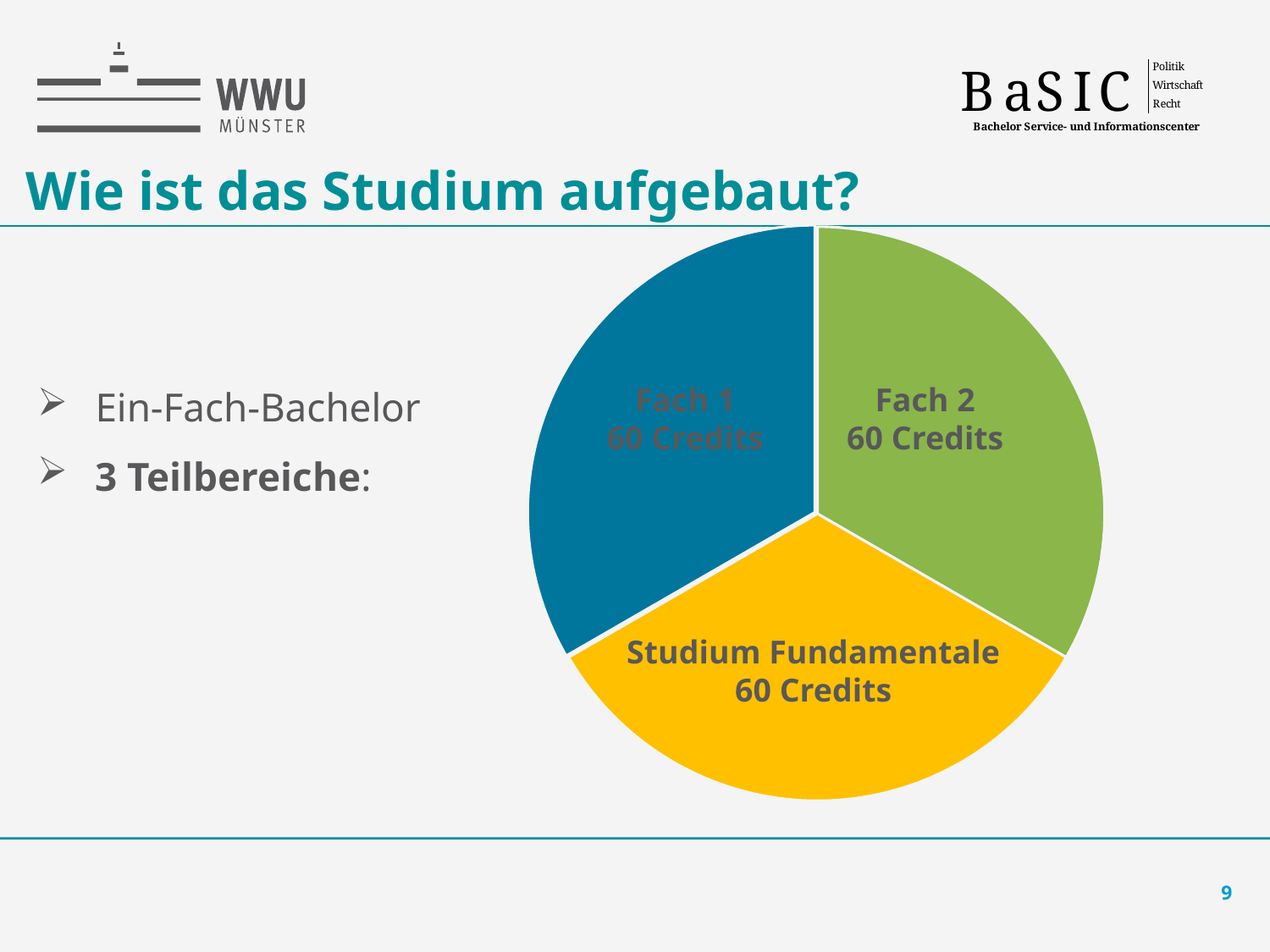
How many credits does the pie chart show for Studium Fundamentale? 60 Credits How many credits does the pie chart show for Fach 2? 60 Credits Which slice of the pie chart is coloured yellow? Studium Fundamentale What is the total number of credits across all three slices of the pie chart? 180 Credits How many slices does the pie chart have? 3 Is the value for Fach 1 larger than, smaller than, or equal to the value for Fach 2? equal How many credits does the pie chart show for Fach 1? 60 Credits What is the difference in credits between Fach 2 and Studium Fundamentale? 0 What colour is the Fach 2 slice of the pie chart? green What kind of chart is shown on the slide? pie chart What share of the pie does the Studium Fundamentale slice represent? one third